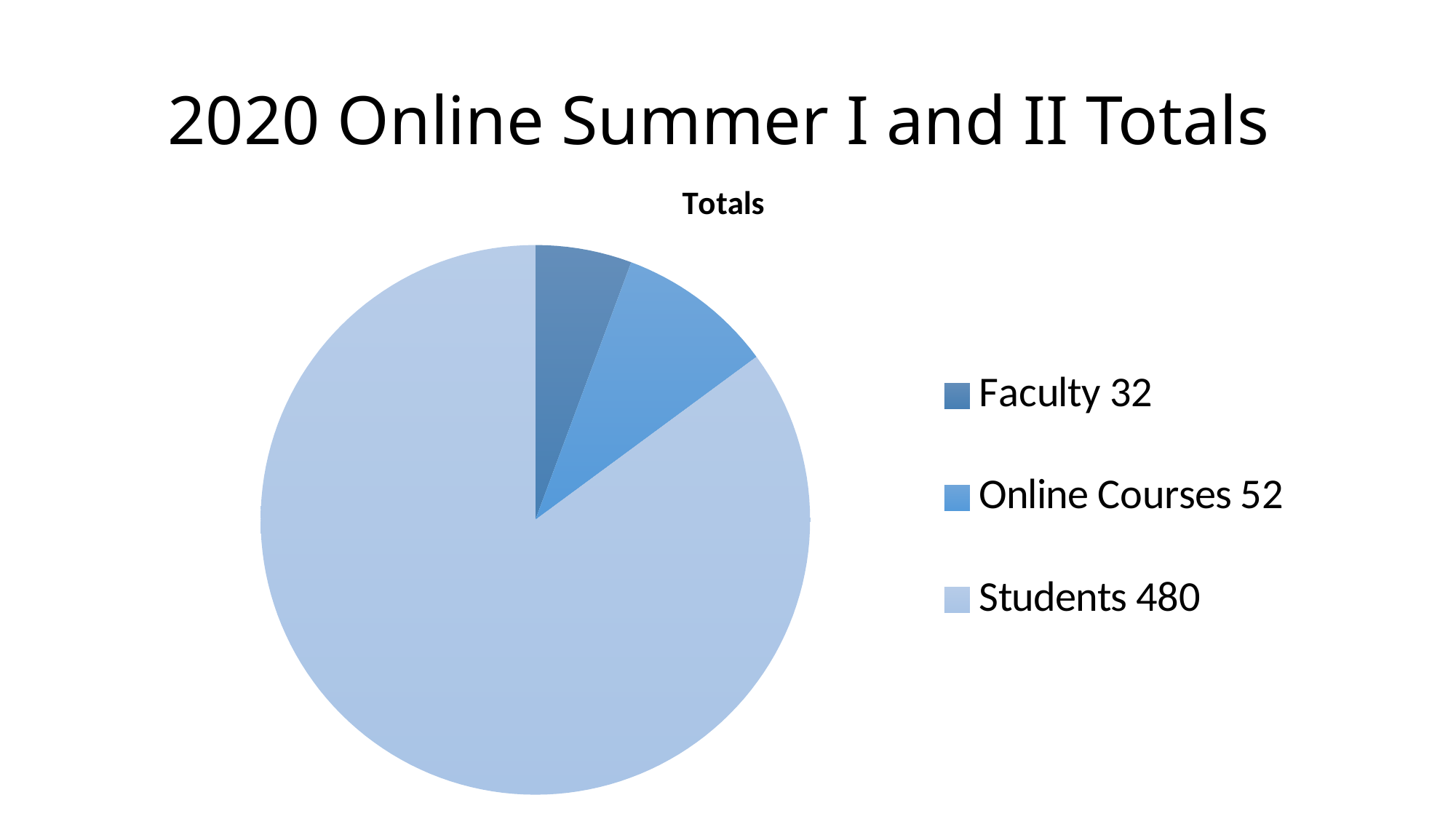
What is the difference between the Students value and the Online Courses value? 428 What is the value for Students in the pie chart? 480 What kind of chart is shown on the slide? pie chart Which is larger, the value for Faculty or the value for Online Courses? Online Courses How many categories does the pie chart have? 3 What is the value for Faculty in the pie chart? 32 What is the sum of all three values shown in the pie chart? 564 What is the title of the chart? Totals What is the value for Online Courses in the pie chart? 52 What is the difference between the Online Courses value and the Faculty value? 20 Which category has the smallest slice of the pie chart? Faculty Which category has the largest slice of the pie chart? Students